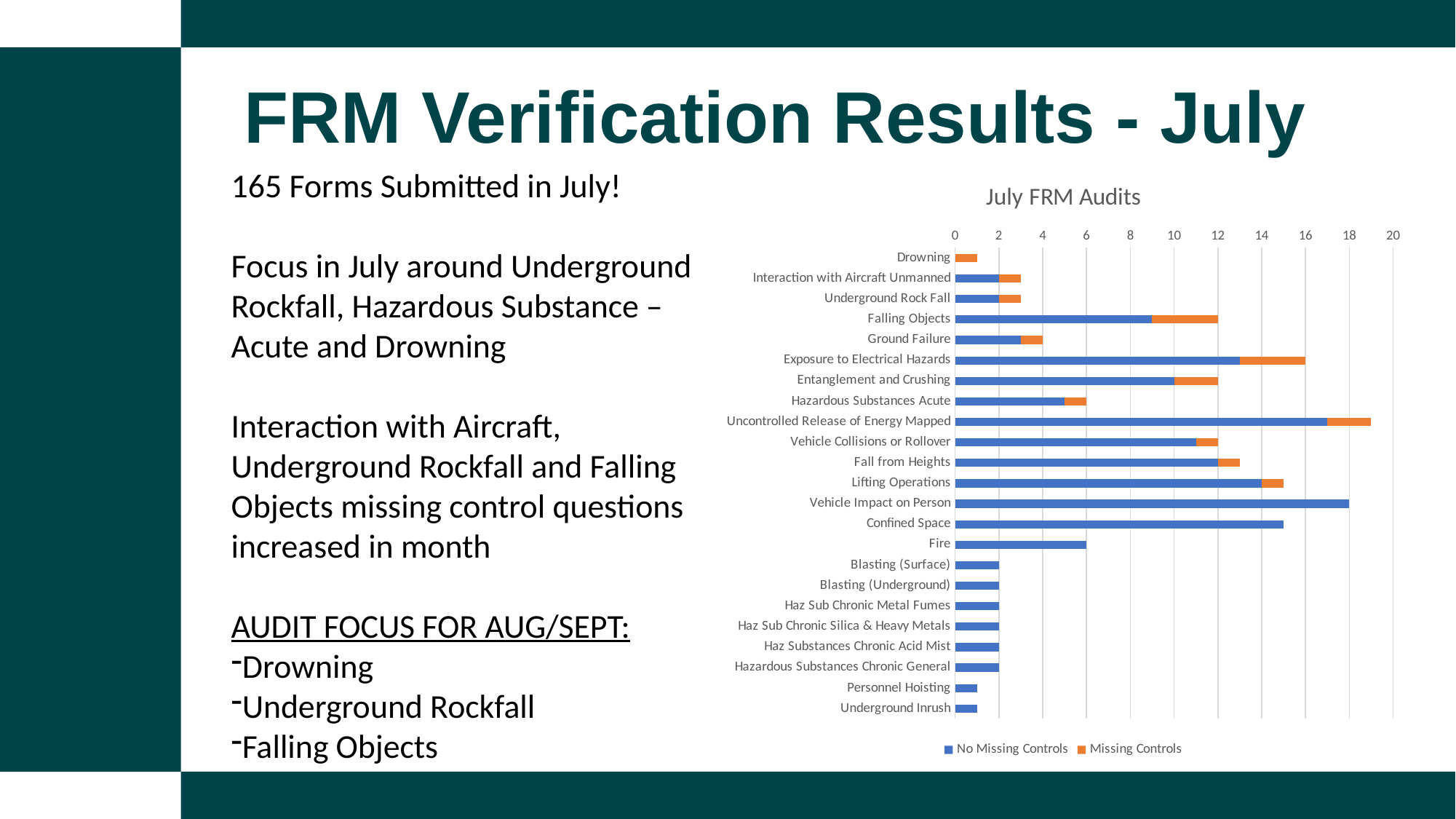
Which has the larger total bar, Falling Objects or Ground Failure? Falling Objects What is the title of the chart? July FRM Audits What is the value for Fire? 6 Is the value for Drowning greater or less than 2? less What is the total bar length for Vehicle Impact on Person? 18 Which category has the longest total bar? Uncontrolled Release of Energy Mapped How many categories are plotted on the chart? 23 Is the total value for Confined Space greater or less than 14? greater What kind of chart is shown on the slide? bar chart What is the total bar length for Exposure to Electrical Hazards? 16 Which series is shown in orange in the legend? Missing Controls How many series does the chart legend list? 2